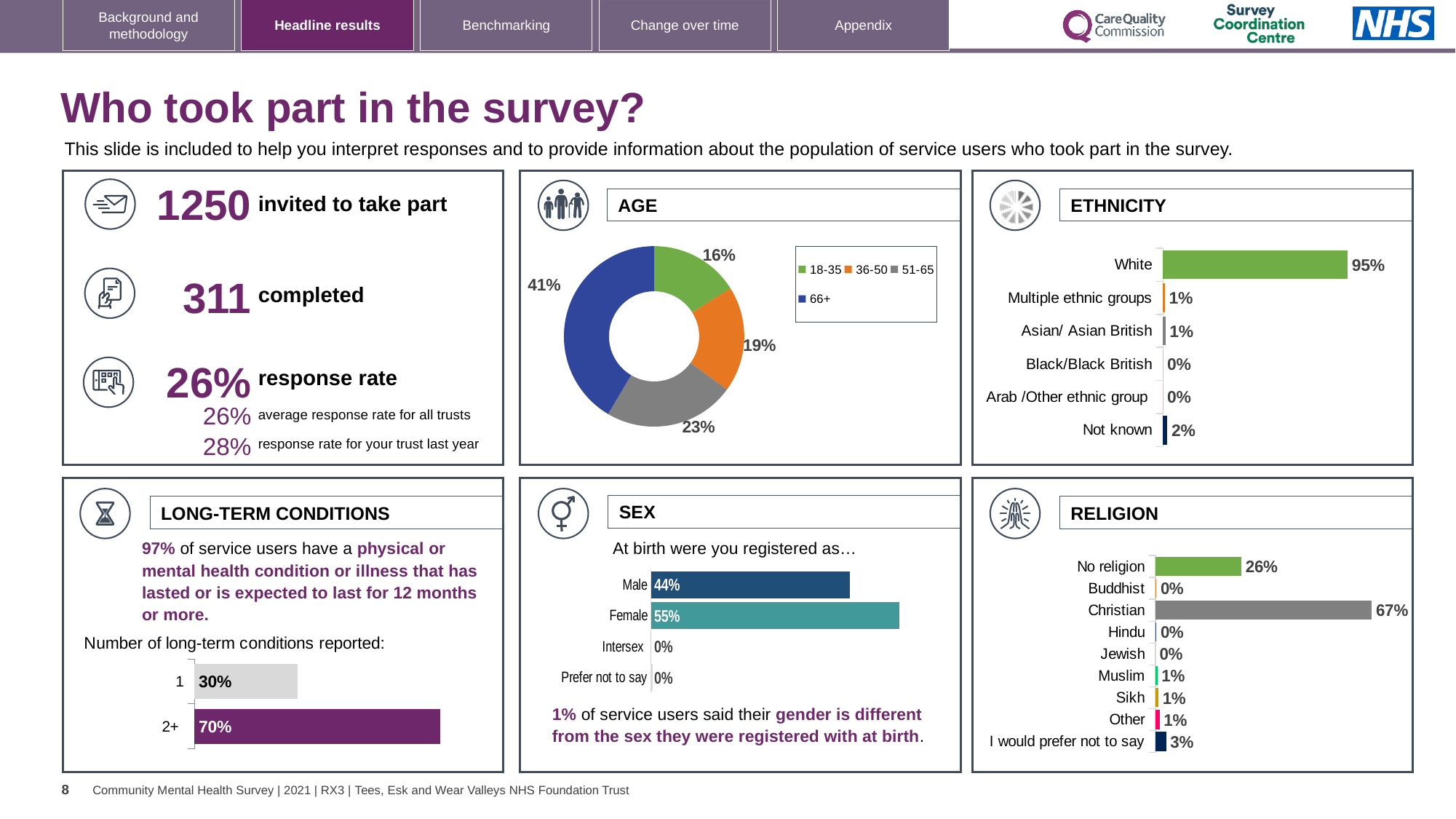
In the AGE chart, what share of respondents were aged 66+? 41% What kind of chart is the AGE chart? Donut (pie) chart In the ETHNICITY chart, what is the value for Not known? 2% In the AGE chart, which age group has the smallest share? 18-35 In the RELIGION chart, which category has the highest value? Christian In the LONG-TERM CONDITIONS chart, what is the difference between the value for 2+ conditions and the value for 1 condition? 40% In the ETHNICITY chart, what is the value for White? 95% How many age groups does the legend of the AGE chart list? 4 How many ethnicity categories are shown in the ETHNICITY chart? 6 In the SEX chart, which is larger, the value for Male or the value for Female? Female How many categories are shown in the RELIGION chart? 9 In the SEX chart, what is the value for Male? 44%